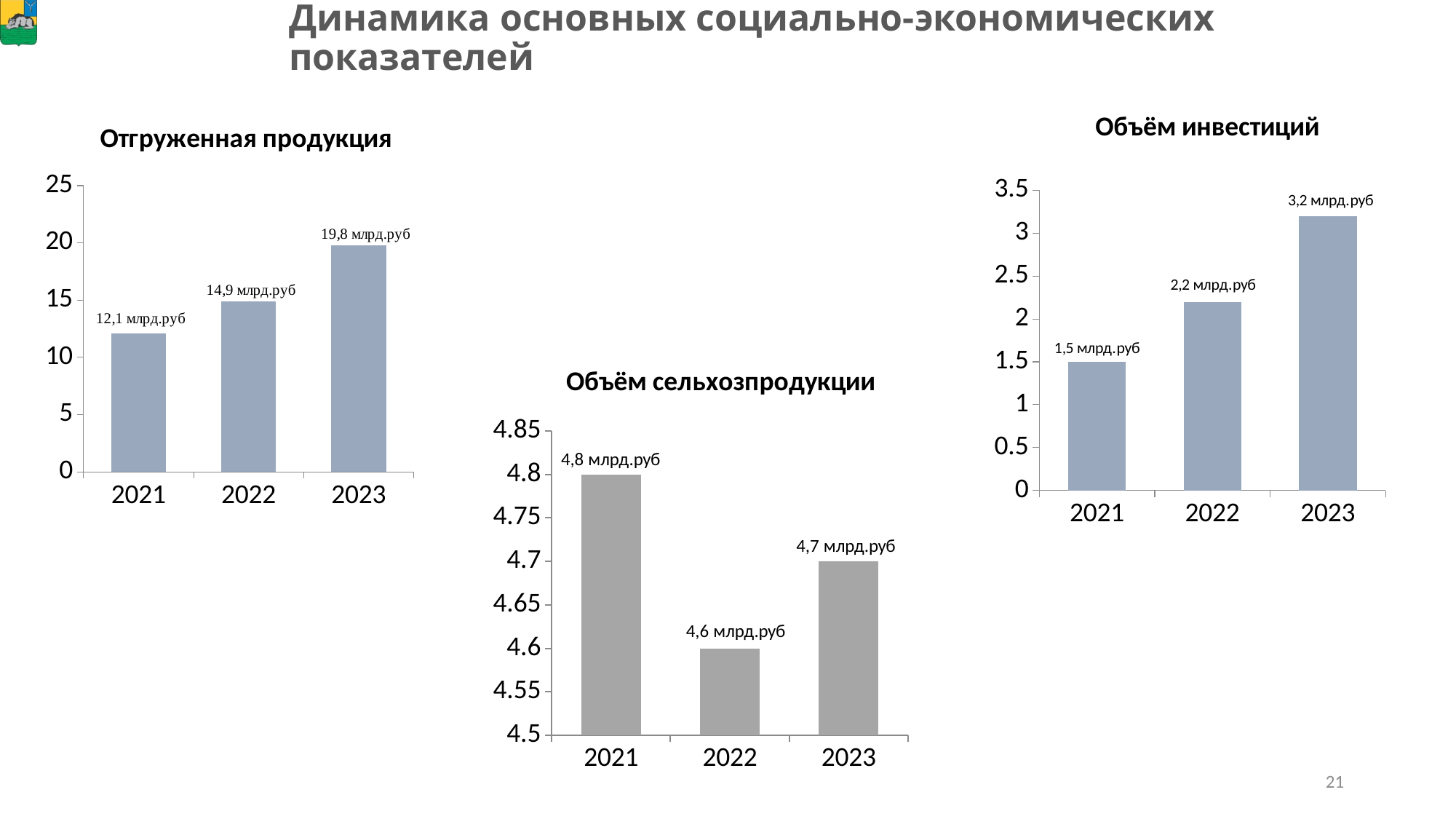
In the 'Отгруженная продукция' chart, what is the difference between the 2023 and 2021 values? 7,7 млрд.руб In the 'Отгруженная продукция' chart, which year has the lowest value? 2021 In the 'Отгруженная продукция' chart, do the values rise or fall from 2021 to 2023? rise In the 'Объём сельхозпродукции' chart, which year has the highest value? 2021 In the 'Объём инвестиций' chart, what is the value for 2021? 1,5 млрд.руб In the 'Объём инвестиций' chart, is the value for 2023 greater or less than 3? greater In the 'Объём сельхозпродукции' chart, what is the value for 2022? 4,6 млрд.руб In the 'Отгруженная продукция' chart, what is the value for 2023? 19,8 млрд.руб How many years are shown in the 'Объём инвестиций' chart? 3 In the 'Объём инвестиций' chart, what is the difference between the 2023 and 2022 values? 1 млрд.руб In the 'Объём сельхозпродукции' chart, which is larger, the value for 2022 or the value for 2023? 2023 What kind of chart is the 'Объём сельхозпродукции' chart? bar chart